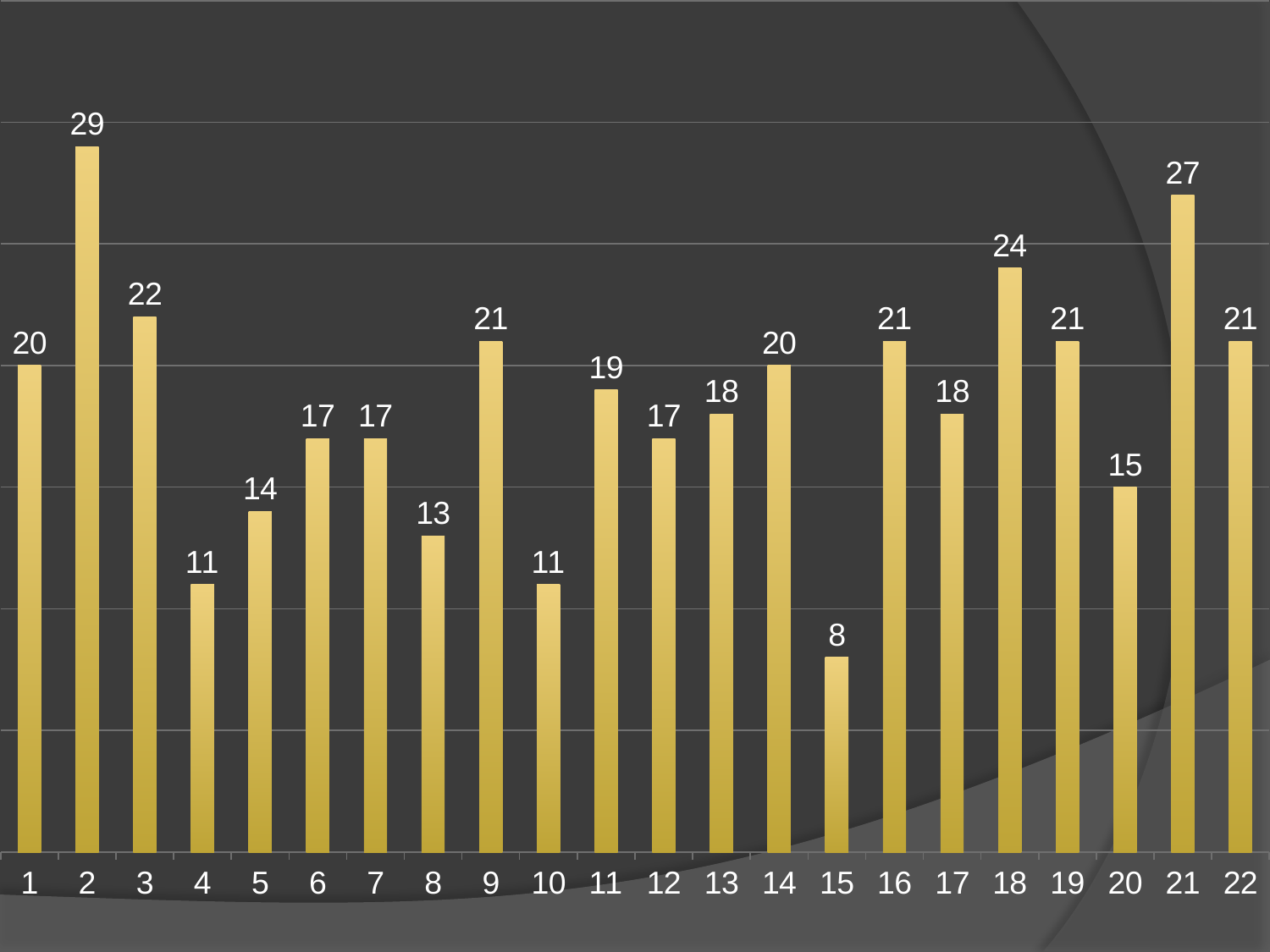
What is the difference between the values for category 2 and category 21? 2 What is the value for category 11? 19 Which is larger, the value for category 3 or the value for category 20? category 3 How many categories are shown on the x axis? 22 Which category has the lowest value? 15 What kind of chart is shown on the slide? bar chart What is the value for category 2? 29 What is the value for category 15? 8 What is the value for category 18? 24 What is the difference between the values for category 18 and category 15? 16 Which category has the highest value? 2 What colour are the bars in the chart? gold